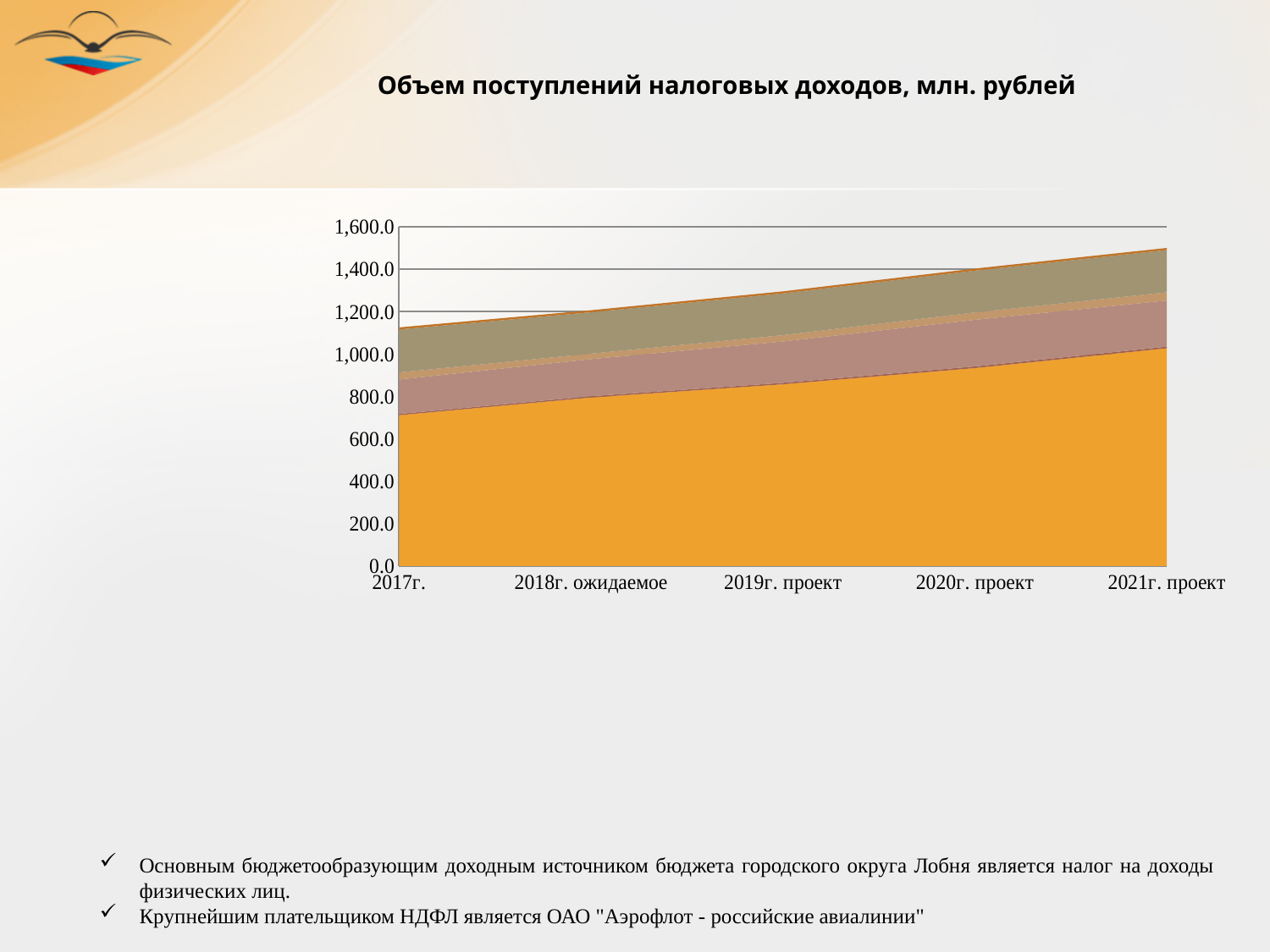
Do the total tax revenues rise or fall from 2017г. to 2021г. проект? rise Is the total tax revenue for 2021г. проект larger than that for 2017г.? yes Is the total tax revenue for 2019г. проект greater or less than 1,200.0? greater Is the value of the bottom (orange) series for 2017г. greater or less than 800.0? less Is the total tax revenue for 2021г. проект greater or less than 1,400.0? greater Which year has the lowest total tax revenue? 2017г. What kind of chart is shown on the slide? area chart How many years (points) are shown along the x axis? 5 What is the title of the chart? Объем поступлений налоговых доходов, млн. рублей Which year has the highest total tax revenue? 2021г. проект